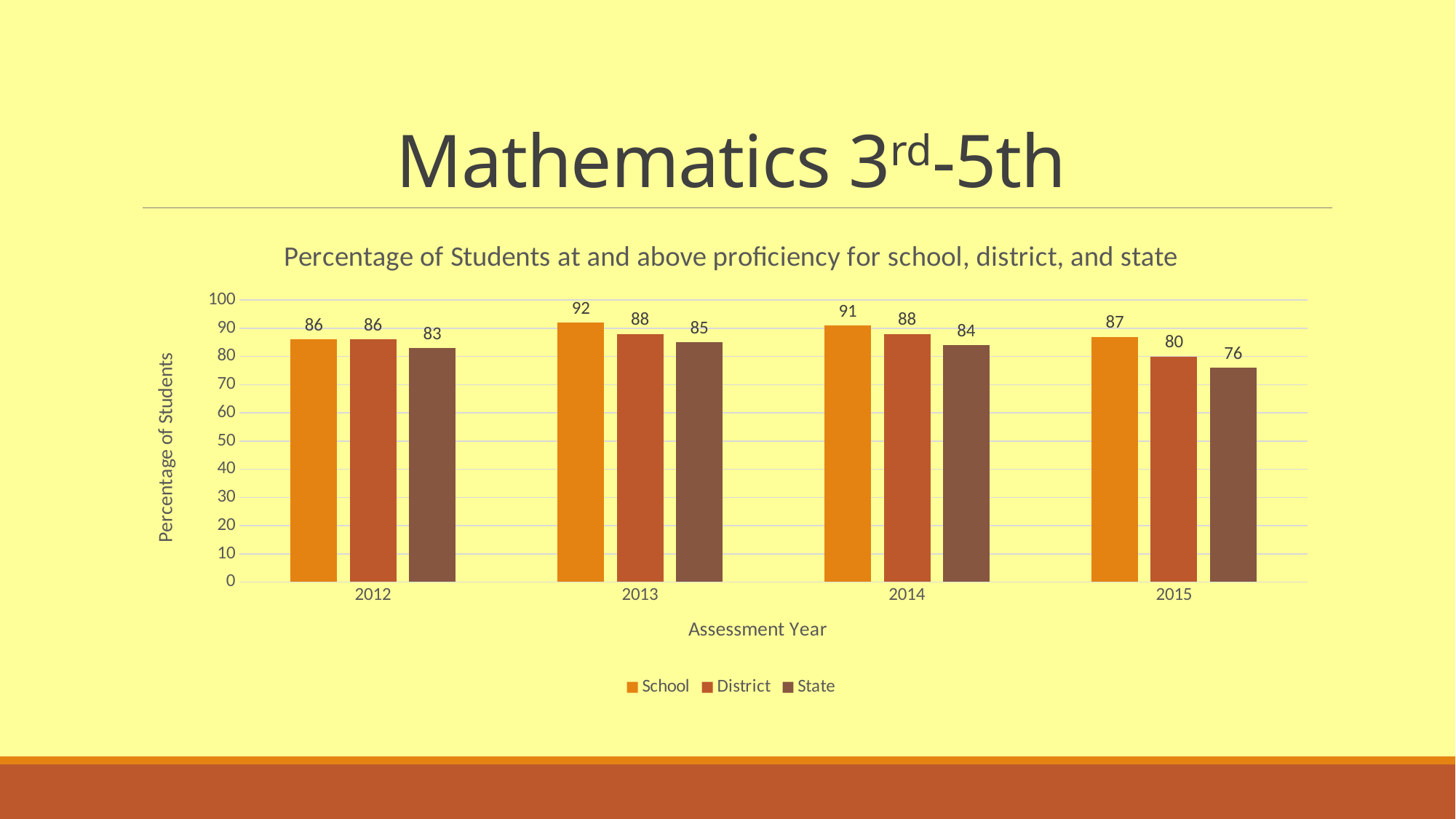
What is the title of the chart? Percentage of Students at and above proficiency for school, district, and state In which year is the State value lowest? 2015 In which year is the School value highest? 2013 What is the School value for 2013? 92 Which is larger in 2014, the School value or the District value? School How many assessment years are shown on the x axis? 4 What kind of chart is shown on the slide? Bar chart What is the State value for 2015? 76 How many series does the legend list? 3 What is the difference between the School and State values in 2015? 11 What is the District value for 2014? 88 Does the State value rise or fall from 2013 to 2015? Fall